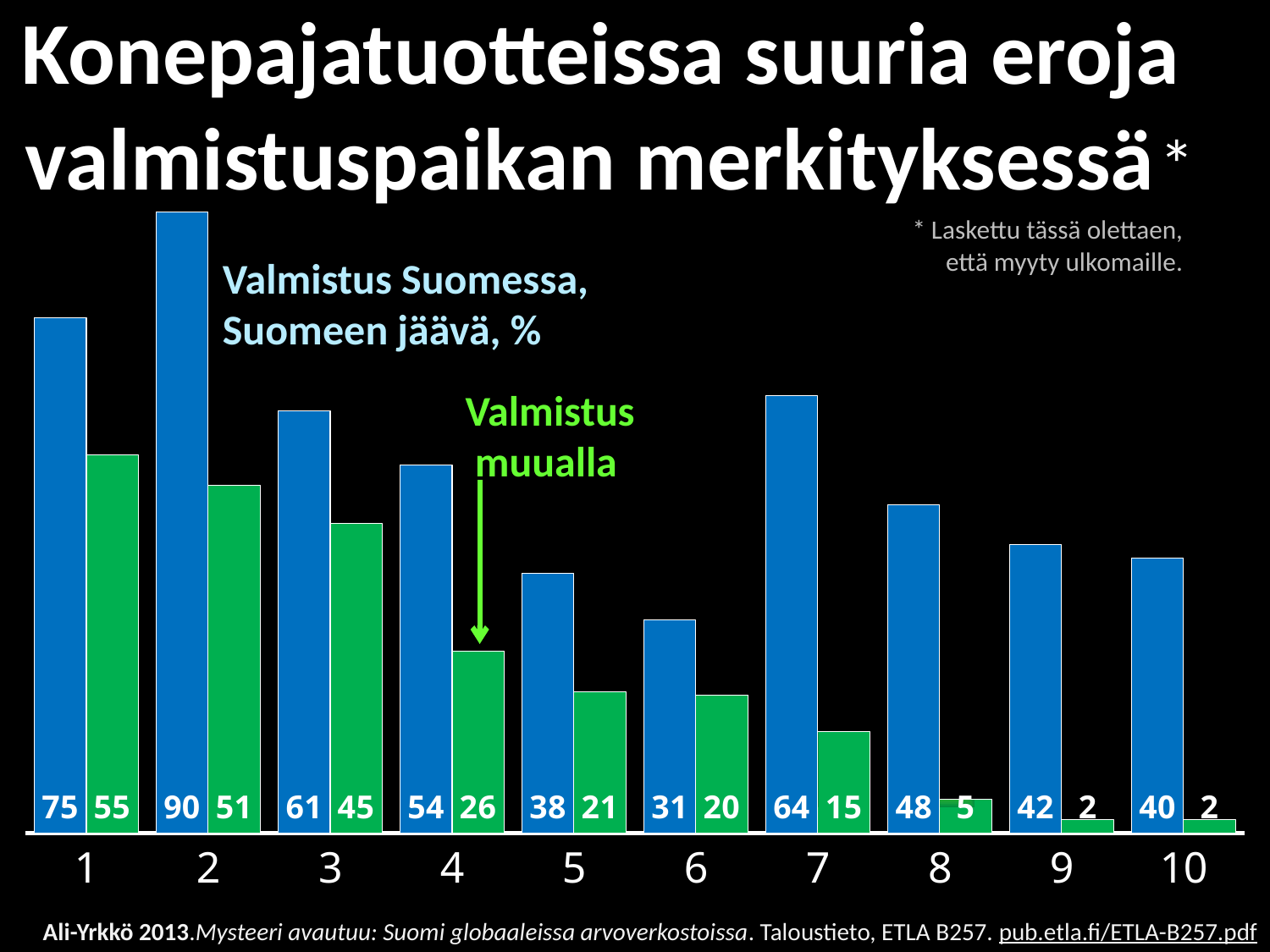
What type of chart is shown on the slide? Bar chart What is the difference between the blue and green bars for category 7? 49 What is the difference between the 'Valmistus Suomessa' values for category 2 and category 1? 15 What is the value for 'Valmistus muualla' (green bar) for category 4? 26 Which category has the highest 'Valmistus muualla' (green bar) value? 1 How many categories are shown on the x axis? 10 Which category has the highest 'Valmistus Suomessa' (blue bar) value? 2 Which is larger: the green bar for category 3 or the green bar for category 5? Category 3 Which category has the lowest 'Valmistus Suomessa' (blue bar) value? 6 How many data series does the chart show? 2 What is the value for 'Valmistus muualla' (green bar) for category 7? 15 What is the value for 'Valmistus Suomessa' (blue bar) for category 2? 90